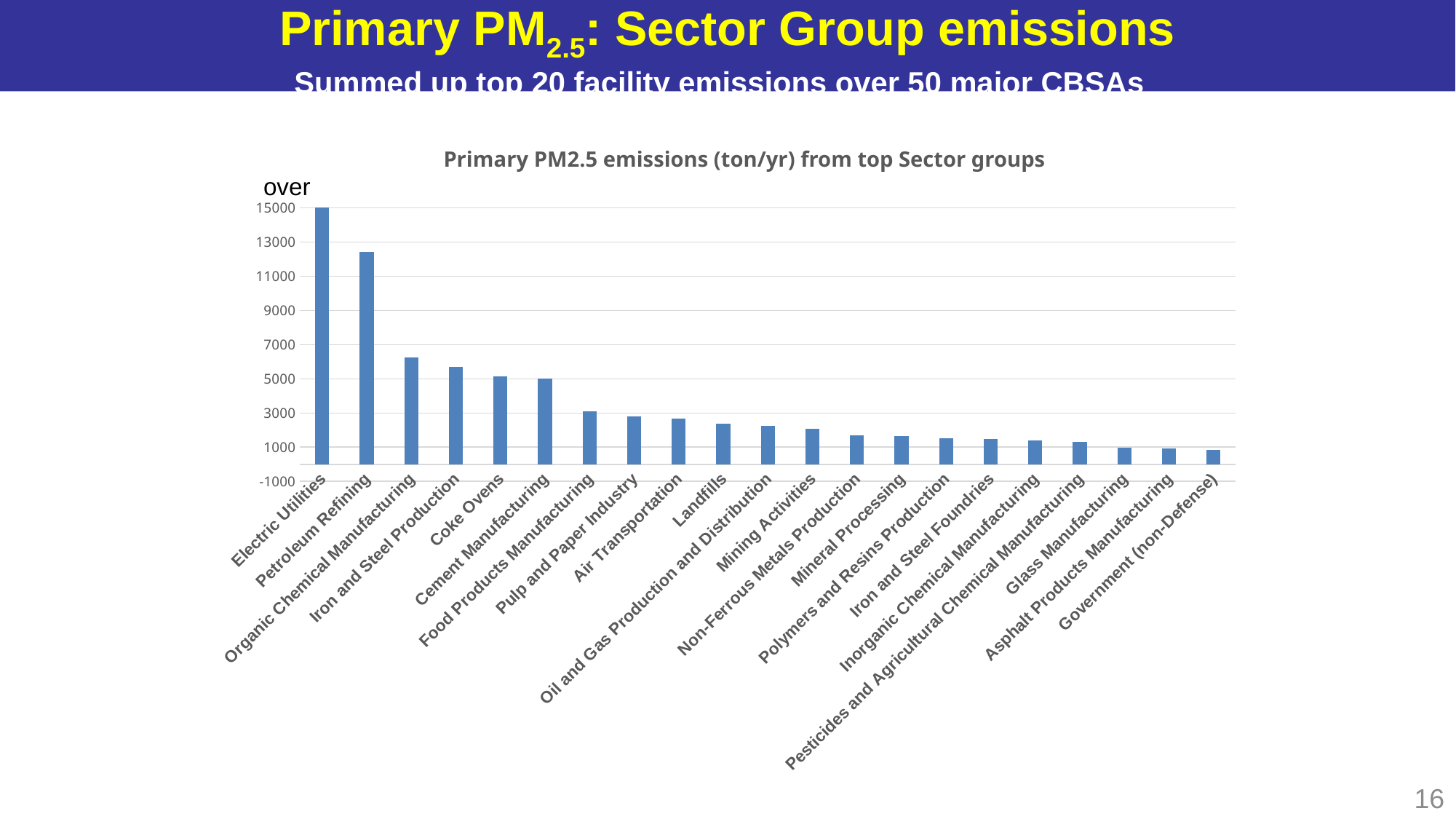
What is the title of the chart? Primary PM2.5 emissions (ton/yr) from top Sector groups What kind of chart is shown on the slide? bar chart Is the value for Petroleum Refining greater or less than 11000? greater Is the value for Food Products Manufacturing greater or less than 5000? less Which sector group has the lowest primary PM2.5 emissions? Government (non-Defense) Which has higher emissions, Petroleum Refining or Organic Chemical Manufacturing? Petroleum Refining Do the bar values rise or fall moving from left to right along the x axis? fall Is the value for Landfills greater or less than 3000? less Which sector group has the highest primary PM2.5 emissions? Electric Utilities How many sector groups are plotted in the chart? 21